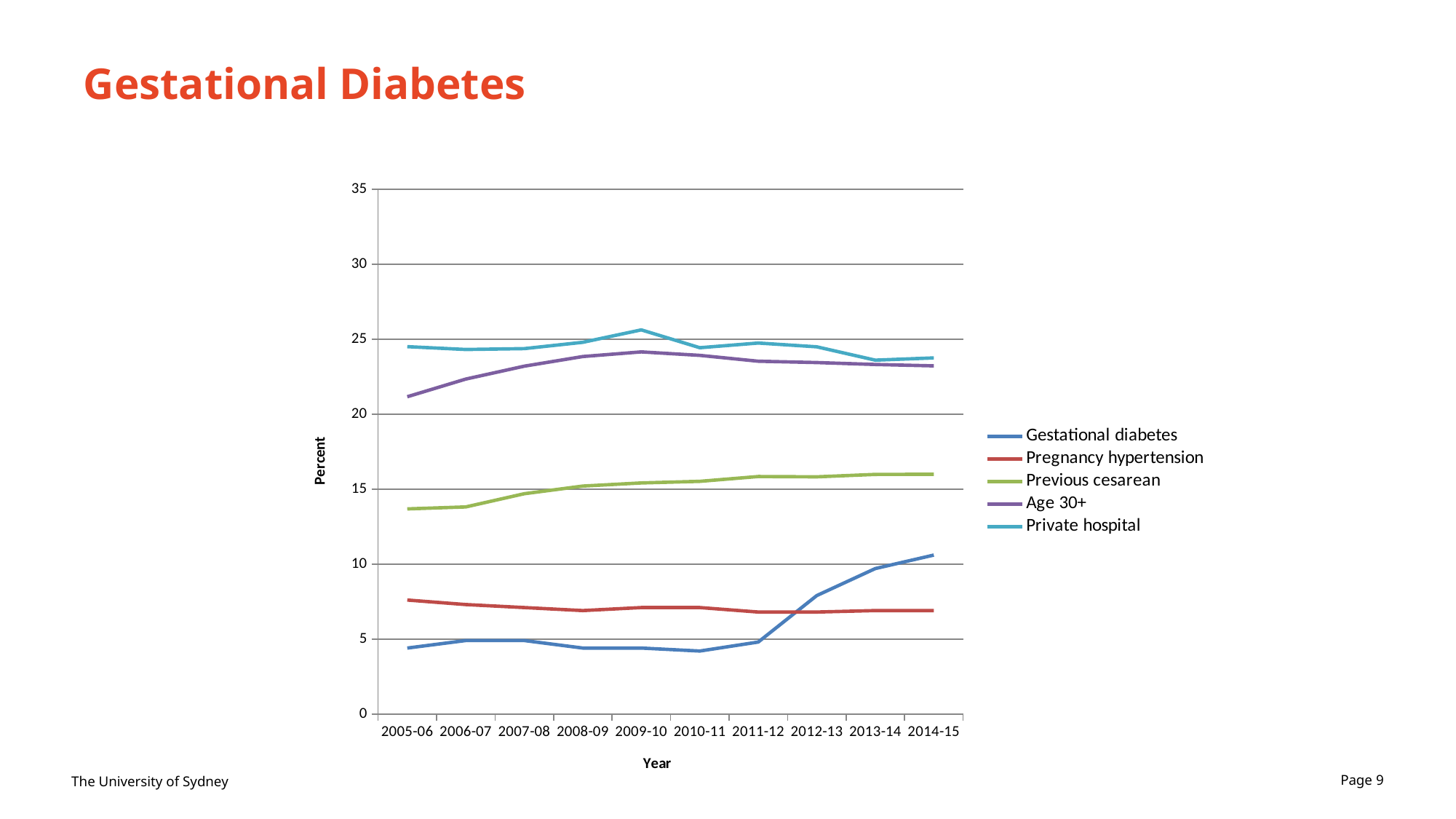
Which series has the lowest value in 2005-06? Gestational diabetes Does the Age 30+ line rise or fall from 2005-06 to 2009-10? rise How many years are shown along the x axis? 10 Is the value for Age 30+ in 2005-06 greater or less than 20? greater In 2005-06, which is higher: Private hospital or Age 30+? Private hospital Is the value for Private hospital in 2009-10 greater or less than 25? greater Is the value for Gestational diabetes in 2014-15 greater or less than 10? greater What kind of chart is shown on the slide? line chart How many series does the legend list? 5 What is the label on the y axis? Percent Does the Gestational diabetes line rise or fall from 2011-12 to 2014-15? rise